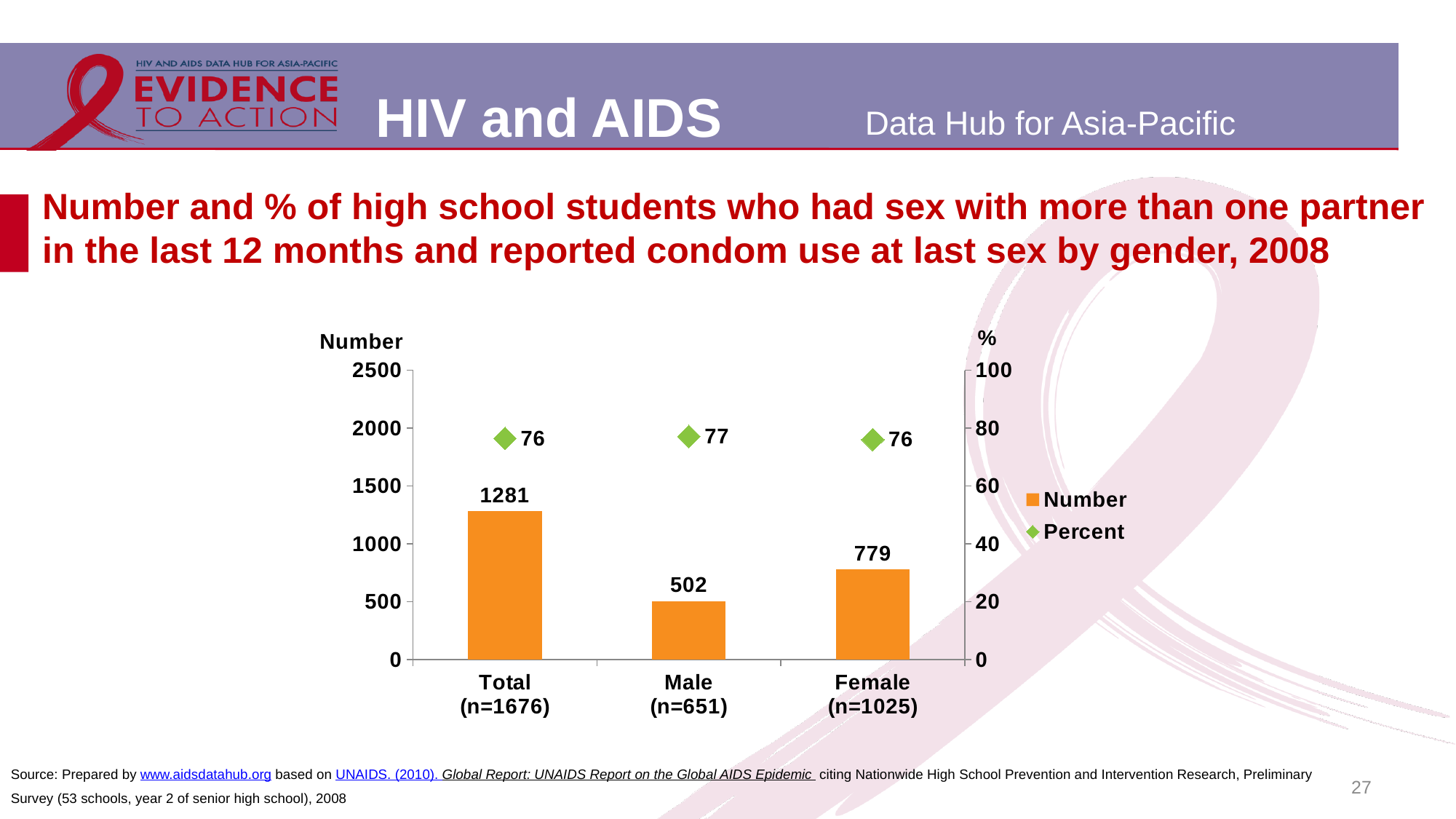
What is the difference between the Number values for Female (n=1025) and Male (n=651)? 277 How many categories are shown on the x axis? 3 Is the Number value for Total (n=1676) greater or less than 1000? greater Which category has the highest Number value? Total (n=1676) How many series does the legend list? 2 What is the Percent value for Total (n=1676)? 76 What is the Number value for Male (n=651)? 502 What is the Number value for Female (n=1025)? 779 What colour are the Number bars? Orange Which has a larger Number value, Male (n=651) or Female (n=1025)? Female (n=1025) What is the Percent value for Male (n=651)? 77 Which category has the lowest Number value? Male (n=651)